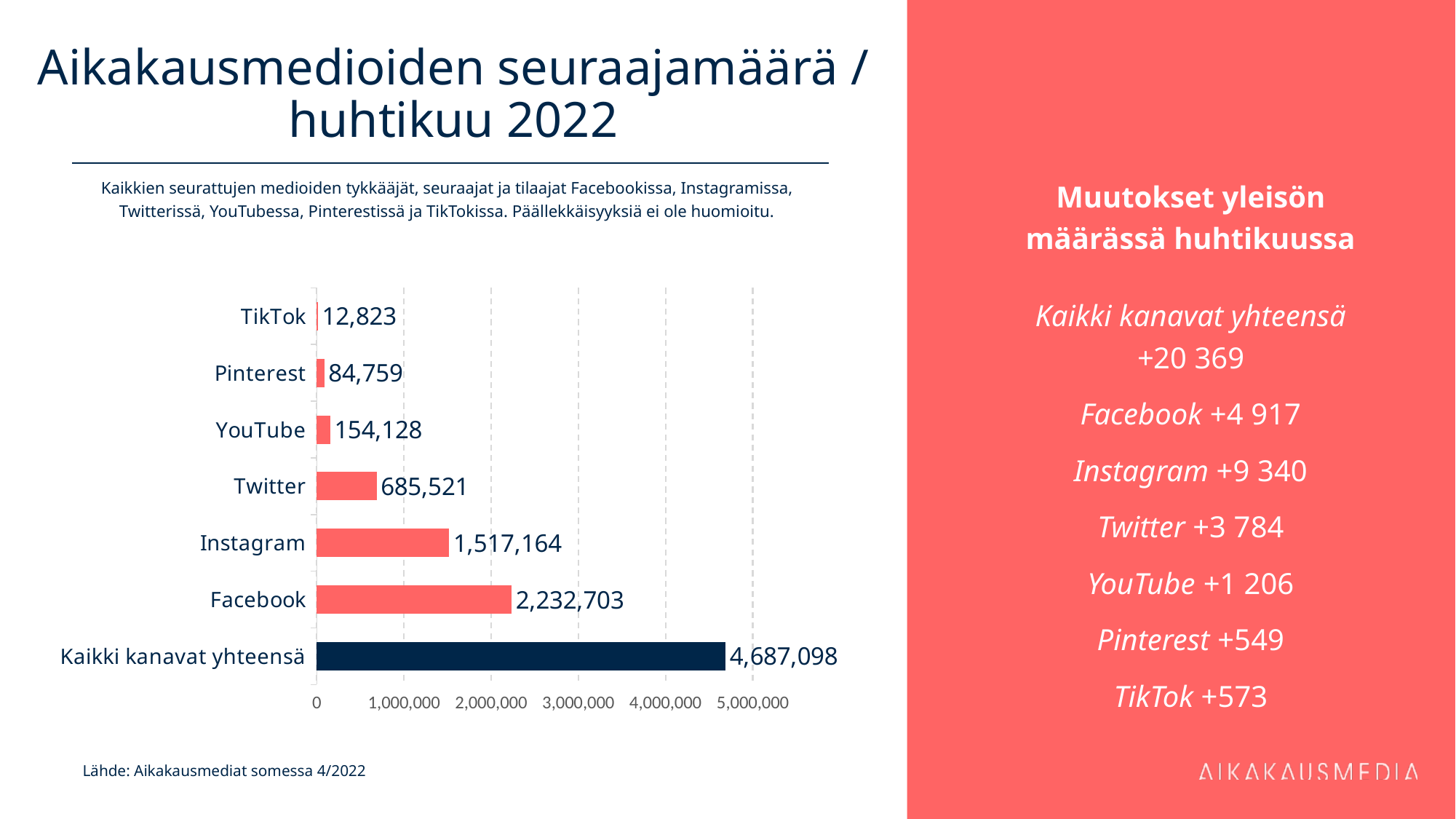
What is the value for Kaikki kanavat yhteensä in the bar chart? 4,687,098 What is the value for TikTok in the bar chart? 12,823 Which category has the highest value in the bar chart? Kaikki kanavat yhteensä How many categories are plotted in the bar chart? 7 What is the value for Instagram in the bar chart? 1,517,164 Is the value for Twitter greater or less than 1,000,000? less What is the difference between the values for Twitter and YouTube? 531,393 What kind of chart is shown on the slide? Bar chart Which category has the lowest value in the bar chart? TikTok What is the value for Facebook in the bar chart? 2,232,703 Which is larger, the value for Instagram or the value for Twitter? Instagram What is the difference between the values for Facebook and Instagram? 715,539